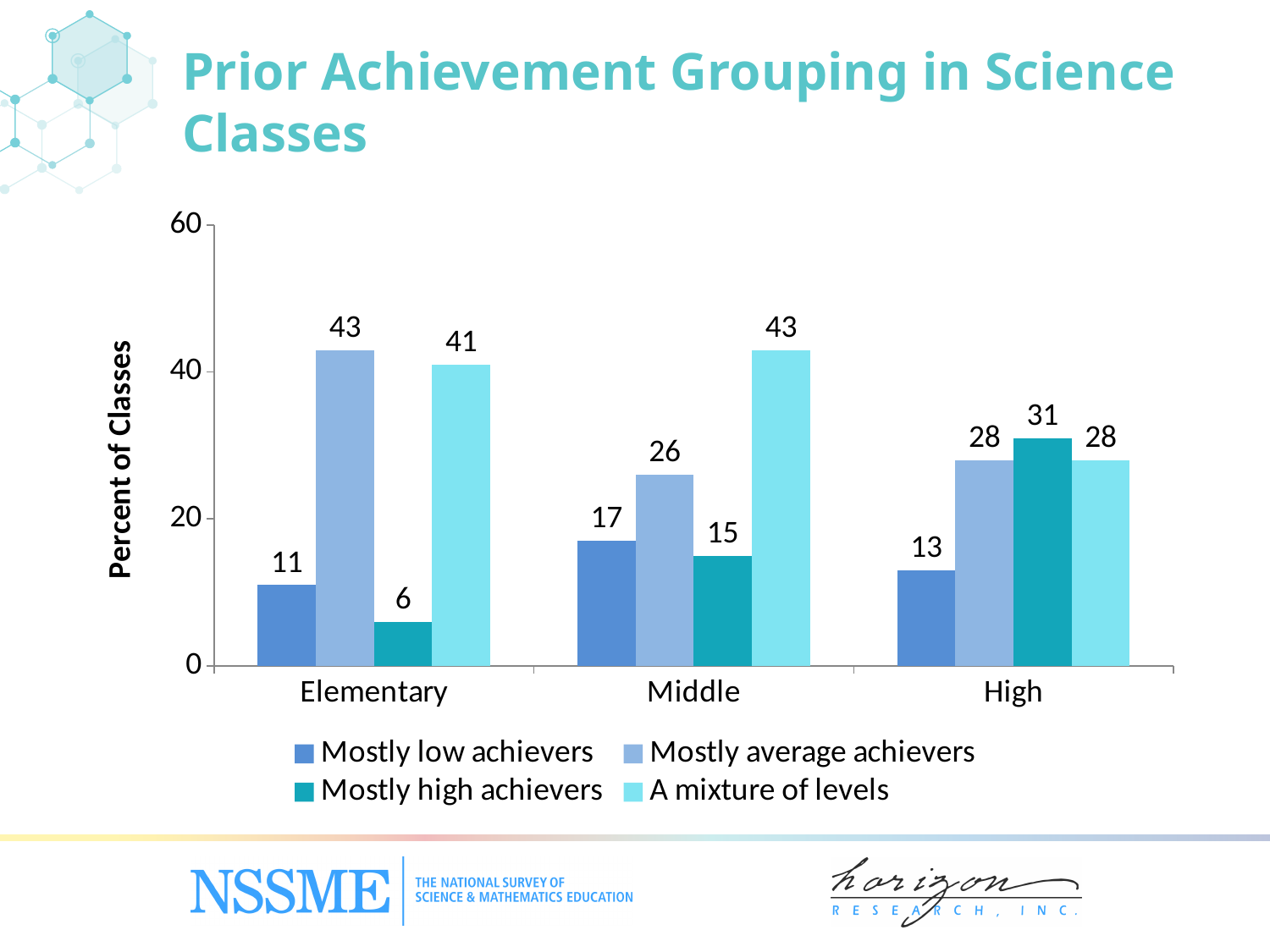
Which grade level has the lowest value for Mostly low achievers? Elementary Is the value for A mixture of levels in Middle school classes greater or less than 40? greater What percent of Elementary classes are mostly average achievers? 43 How many series does the legend list? 4 What is the label of the y axis? Percent of Classes What kind of chart is shown on the slide? Bar chart What is the difference between the Mostly average achievers values for Elementary and Middle? 17 What percent of High school classes have a mixture of levels? 28 Which is larger for Middle school classes: Mostly low achievers or Mostly high achievers? Mostly low achievers How many grade-level categories are shown on the x axis? 3 Which grade level has the highest value for Mostly high achievers? High What is the value for Mostly high achievers in Middle school classes? 15